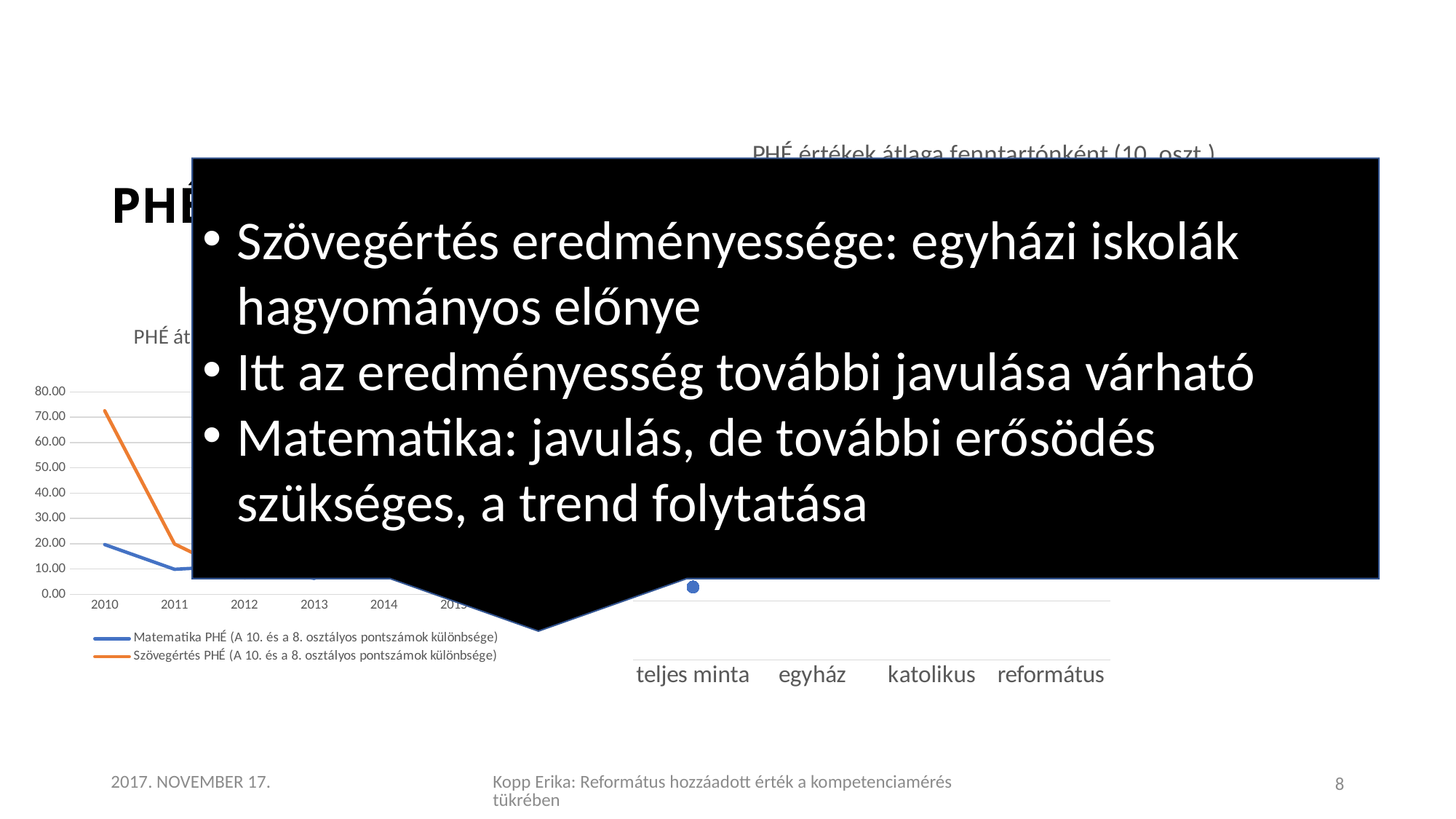
What are the category labels on the x axis of the chart on the right of the slide? teljes minta, egyház, katolikus, református In the left chart, does the Szövegértés PHÉ line rise or fall from 2010 to 2011? fall In the left chart, is the Matematika PHÉ value for 2010 greater or less than 30? less In the left chart, is the Szövegértés PHÉ value for 2010 greater or less than 60? greater In the left chart, does the Matematika PHÉ line rise or fall from 2010 to 2011? fall What is the title of the chart on the right of the slide? PHÉ értékek átlaga fenntartónként (10. oszt.) How many categories are shown on the x axis of the chart on the right of the slide? 4 In the left chart, which series has the higher value in 2010, Matematika PHÉ or Szövegértés PHÉ? Szövegértés PHÉ In the left chart, is the Szövegértés PHÉ value for 2011 greater or less than 40? less What kind of chart is the chart on the left of the slide? line chart How many series does the legend of the left chart list? 2